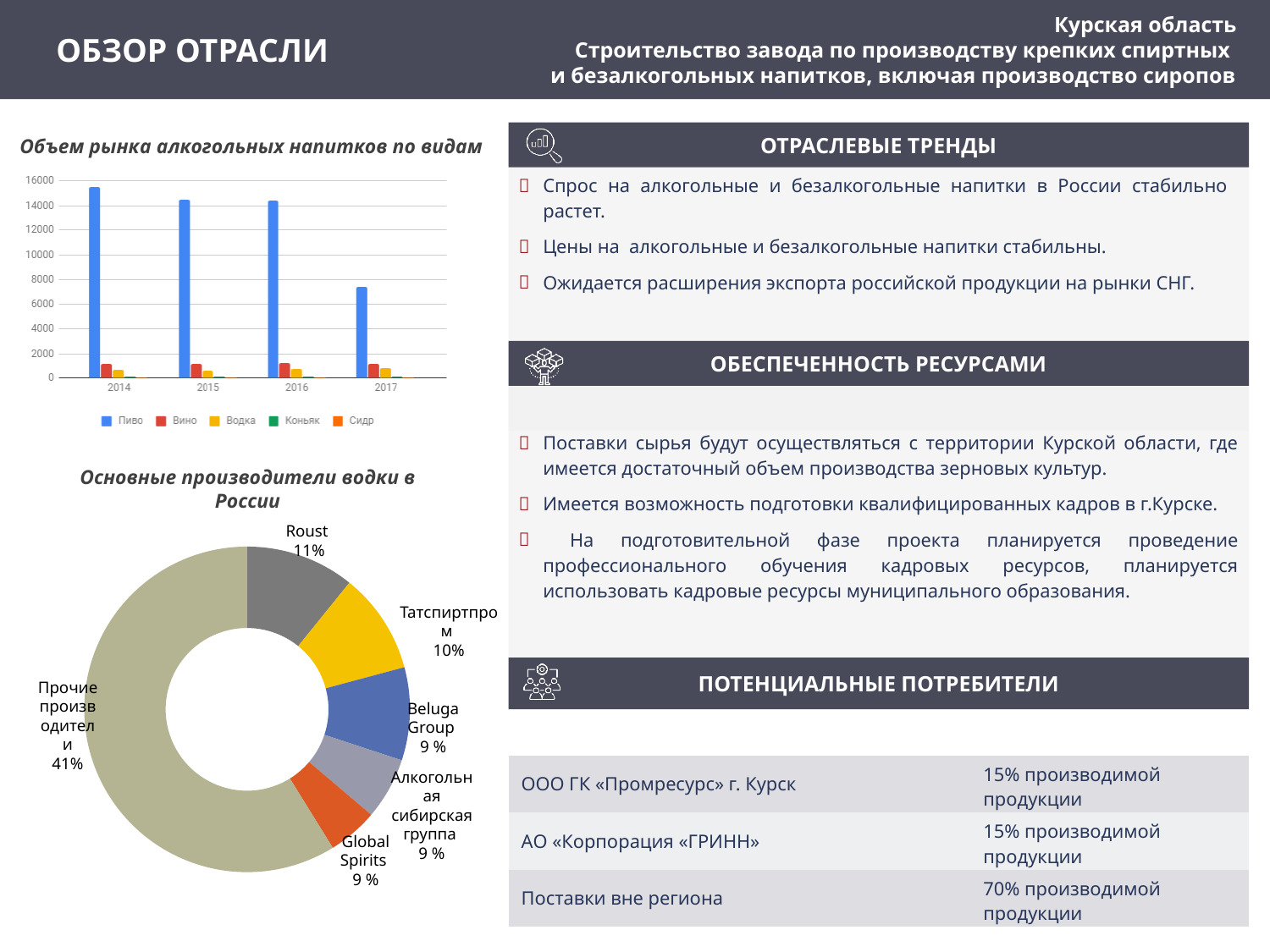
How many series does the legend of 'Объем рынка алкогольных напитков по видам' list? 5 In 'Объем рынка алкогольных напитков по видам', is the value for Пиво in 2017 greater or less than 8000? less In 'Основные производители водки в России', which has the larger share, Roust or Татспиртпром? Roust What kind of chart is 'Объем рынка алкогольных напитков по видам'? bar chart In 'Объем рынка алкогольных напитков по видам', which year has the lowest value for Пиво? 2017 In 'Объем рынка алкогольных напитков по видам', which year has the highest value for Пиво? 2014 In 'Объем рынка алкогольных напитков по видам', is the value for Пиво in 2014 greater or less than 14000? greater In 'Основные производители водки в России', which category has the largest share? Прочие производители How many years are shown on the x axis of 'Объем рынка алкогольных напитков по видам'? 4 In 'Основные производители водки в России', what is the difference between the shares of Прочие производители and Roust? 30% In 'Объем рынка алкогольных напитков по видам', does the value for Пиво rise or fall from 2014 to 2017? fall In 'Основные производители водки в России', what share does Roust have? 11%